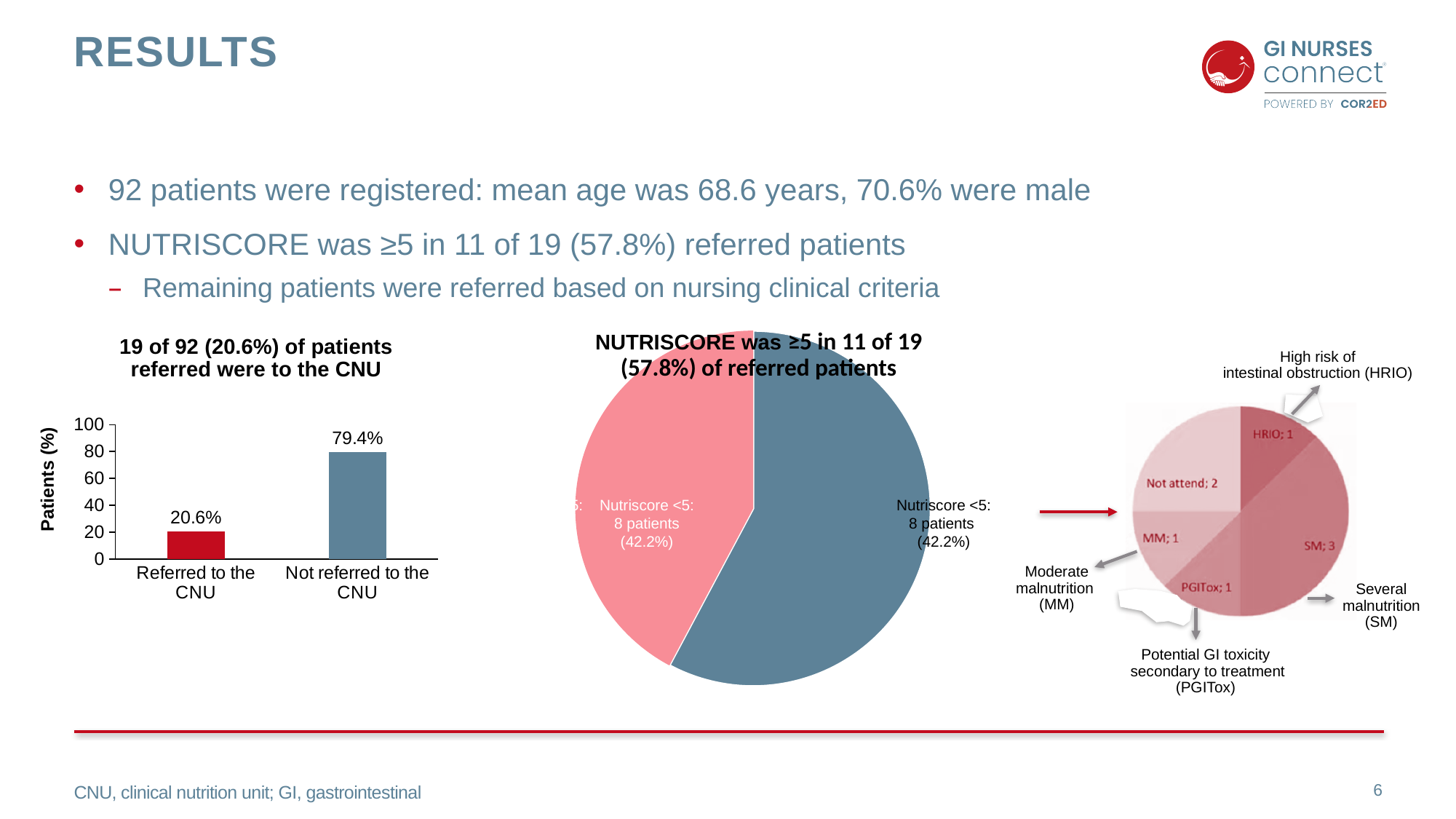
In the pie chart on the right, which category has the largest value? SM In the bar chart on the left, which category has the higher value? Not referred to the CNU What type of chart is the chart on the left of the slide? Bar chart In the bar chart on the left, is the value for 'Not referred to the CNU' greater or less than 60? greater In the bar chart on the left, what is the value for 'Not referred to the CNU'? 79.4% In the pie chart on the right, how many slices are there? 5 In the bar chart on the left, what is the value for 'Referred to the CNU'? 20.6% In the middle pie chart, what percentage is shown for the 'Nutriscore <5' slice? 42.2% In the bar chart on the left, what is the difference between the 'Not referred to the CNU' and 'Referred to the CNU' values? 58.8% In the middle pie chart, how many patients are in the 'Nutriscore <5' slice? 8 patients In the bar chart on the left, what is the y-axis label? Patients (%) In the pie chart on the right, what is the value for 'SM'? 3